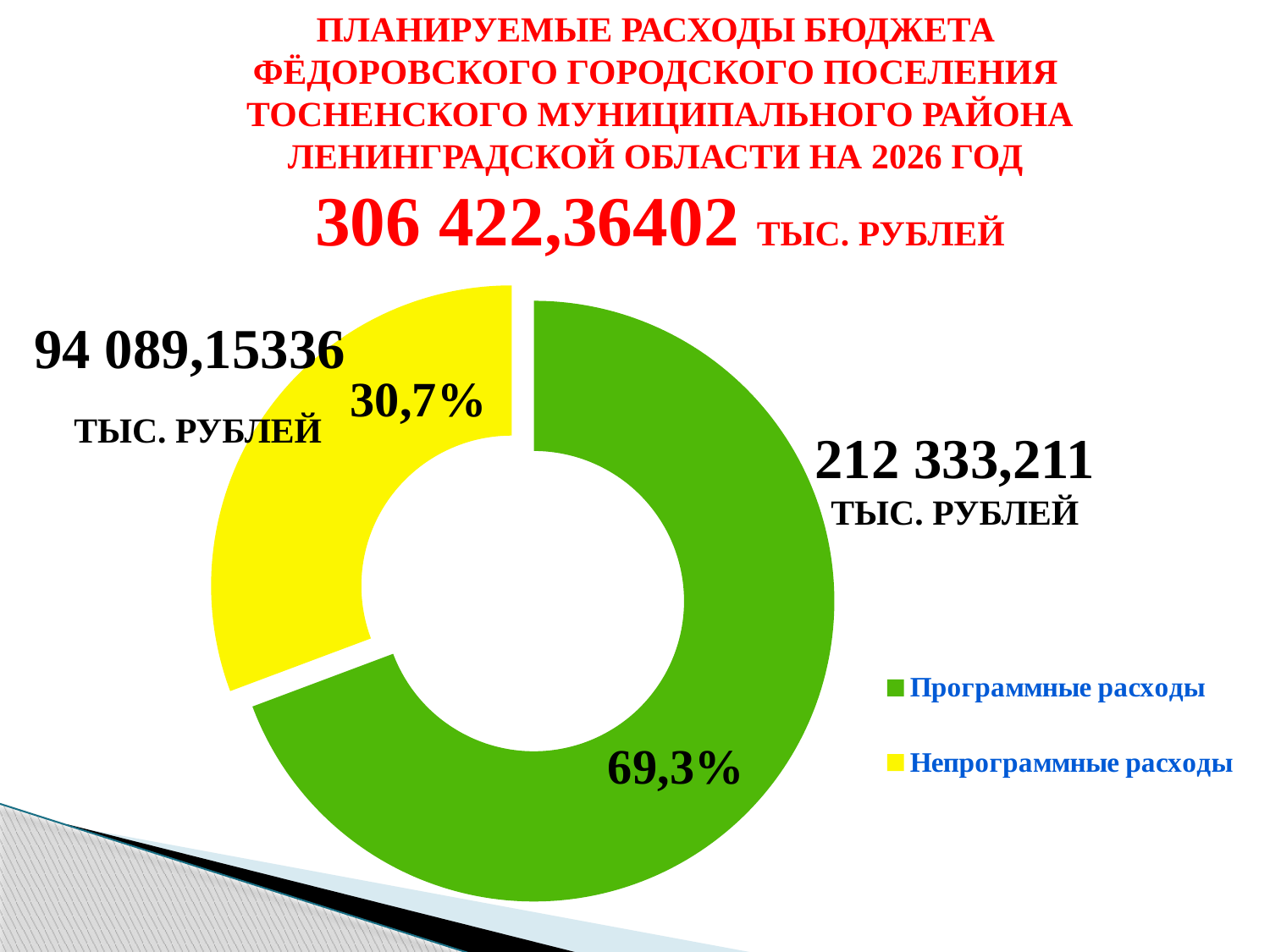
What total amount in тыс. рублей is stated in the slide title for 2026? 306 422,36402 What share of the chart does Программные расходы take? 69,3% What is the value shown for Непрограммные расходы in тыс. рублей? 94 089,15336 Which is larger, Программные расходы or Непрограммные расходы? Программные расходы Which category has the largest share of the chart? Программные расходы What kind of chart is shown on the slide? Doughnut (pie) chart What is the value shown for Программные расходы in тыс. рублей? 212 333,211 What share of the chart does Непрограммные расходы take? 30,7% How many categories does the chart show? 2 What colour represents Непрограммные расходы in the chart? Yellow What is the difference in percentage points between the shares of Программные расходы and Непрограммные расходы? 38,6 Which category has the smallest share of the chart? Непрограммные расходы